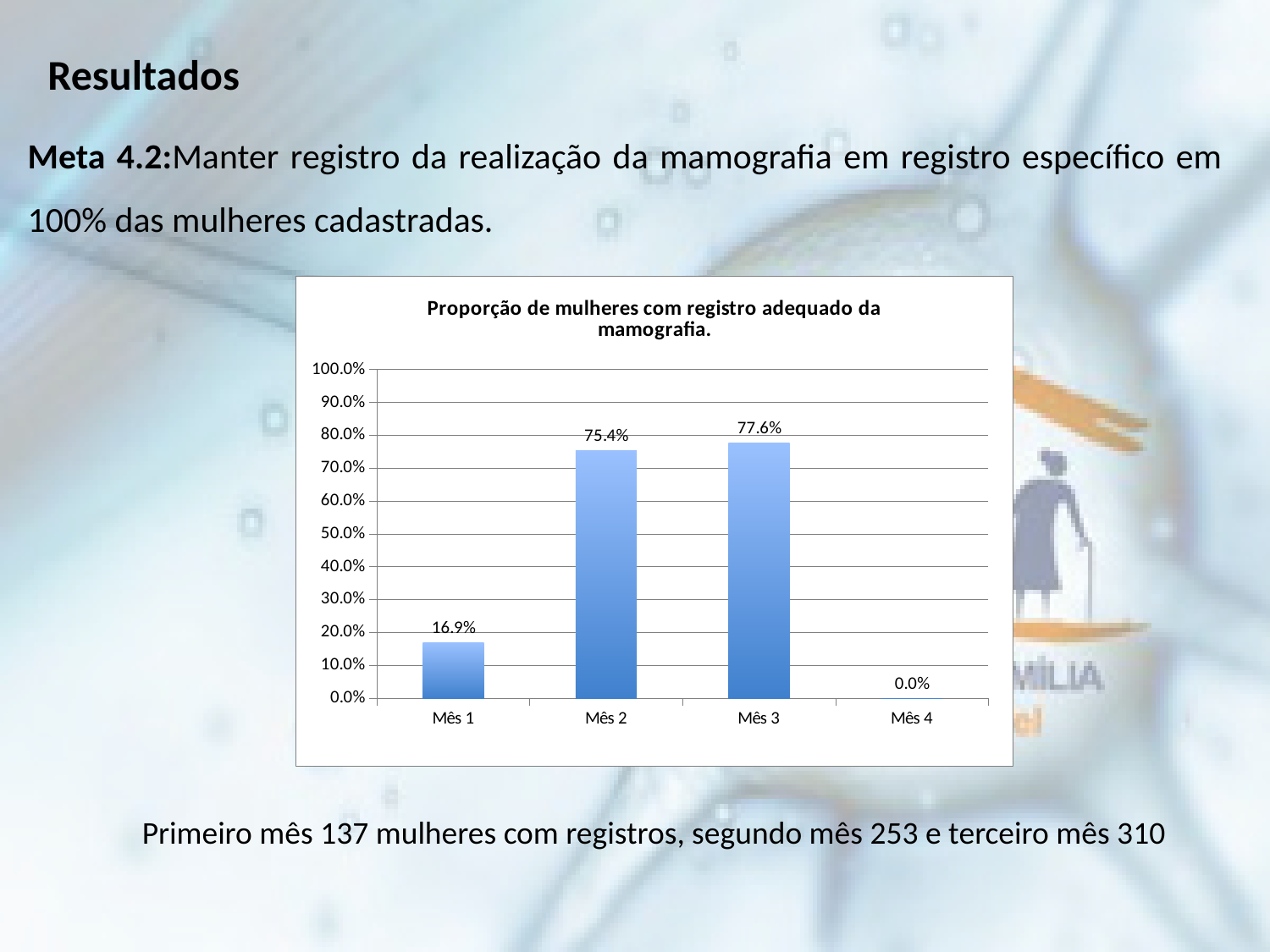
What is the value for Mês 1? 16.9% Which month has the highest value? Mês 3 What is the title of the chart? Proporção de mulheres com registro adequado da mamografia. What is the difference between the values for Mês 2 and Mês 1? 58.5% What is the value for Mês 2? 75.4% What is the value for Mês 4? 0.0% What kind of chart is shown on the slide? Bar chart What is the value for Mês 3? 77.6% Which is larger, the value for Mês 1 or the value for Mês 2? Mês 2 What is the difference between the values for Mês 3 and Mês 2? 2.2% Which month has the lowest value? Mês 4 How many categories are shown on the x axis? 4